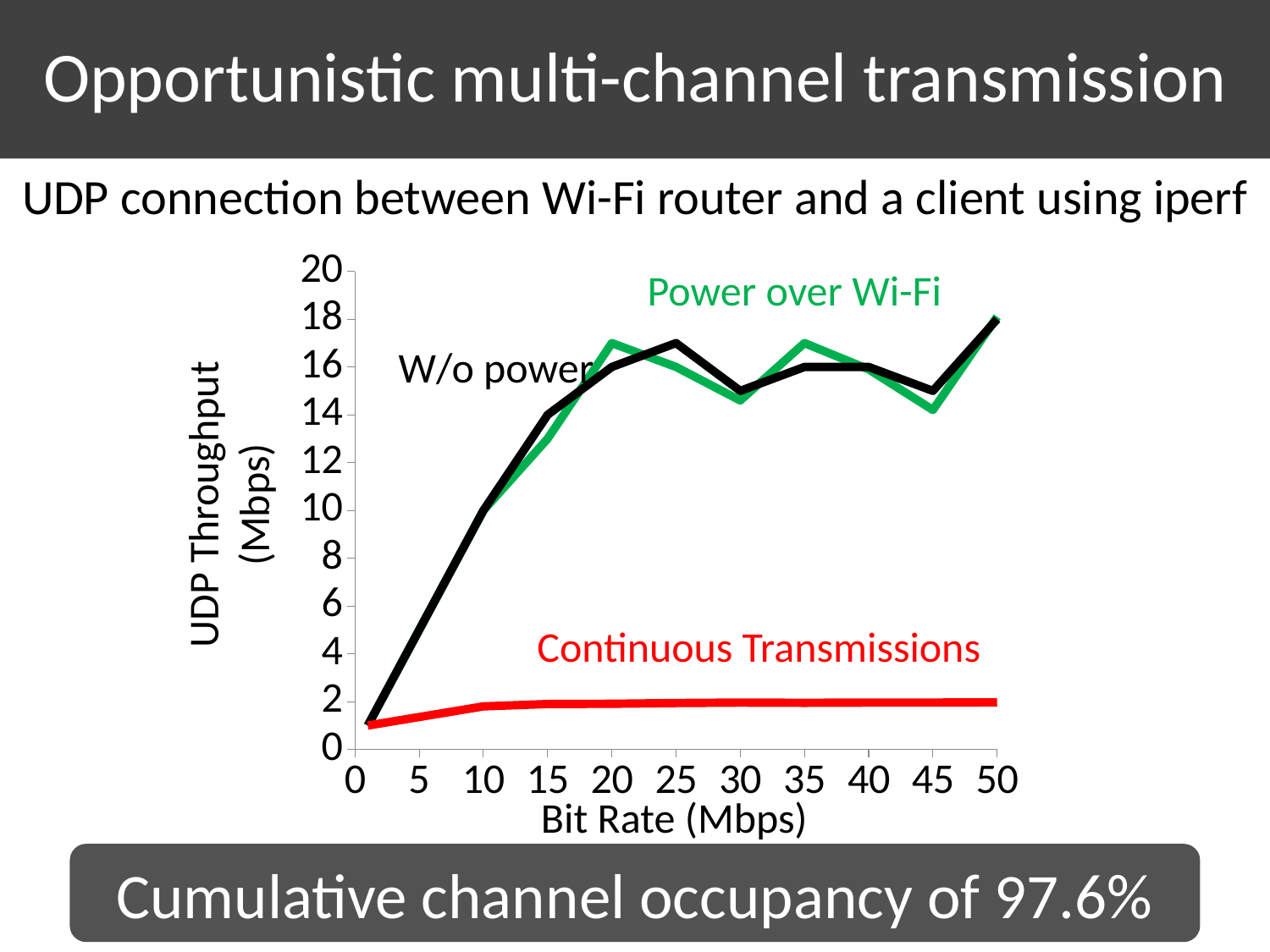
Is the UDP throughput for Power over Wi-Fi at a bit rate of 50 Mbps greater or less than 16? greater What kind of chart is shown on the slide? line chart At a bit rate of 30 Mbps, which has the higher UDP throughput, Continuous Transmissions or W/o power? W/o power Is the UDP throughput for Power over Wi-Fi at a bit rate of 20 Mbps greater or less than 14? greater How many data series are plotted on the chart? 3 Does the W/o power line rise or fall as the bit rate increases from 0 to 20 Mbps? rise Is the UDP throughput for W/o power at a bit rate of 5 Mbps greater or less than 10? less Does the Continuous Transmissions line rise or fall as the bit rate increases from 0 to 10 Mbps? rise What colour is the Continuous Transmissions line? red What is the title of the x axis of the chart? Bit Rate (Mbps) Which series has the lowest UDP throughput at a bit rate of 50 Mbps? Continuous Transmissions